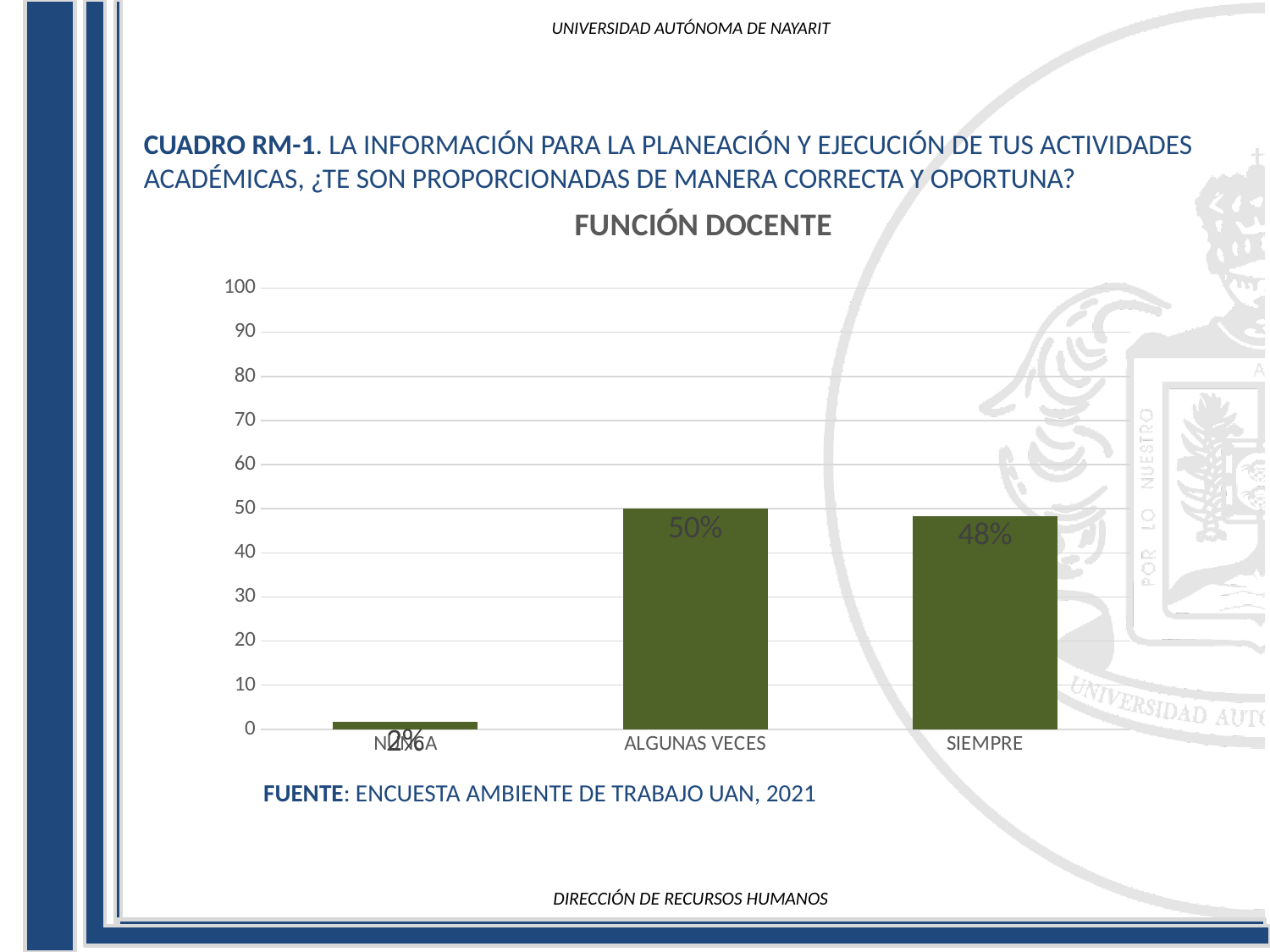
What is the difference between the values for ALGUNAS VECES and SIEMPRE? 2% Which category has the lowest value? NUNCA Which is larger, the value for SIEMPRE or the value for NUNCA? SIEMPRE What is the difference between the values for SIEMPRE and NUNCA? 46% What kind of chart is shown under the title FUNCIÓN DOCENTE? bar chart What is the value for NUNCA? 2% Which category has the highest value? ALGUNAS VECES What is the value for ALGUNAS VECES? 50% What is the title of the chart? FUNCIÓN DOCENTE What is the value for SIEMPRE? 48% How many categories are shown on the x axis of the chart? 3 Is the value for SIEMPRE greater or less than 40? greater